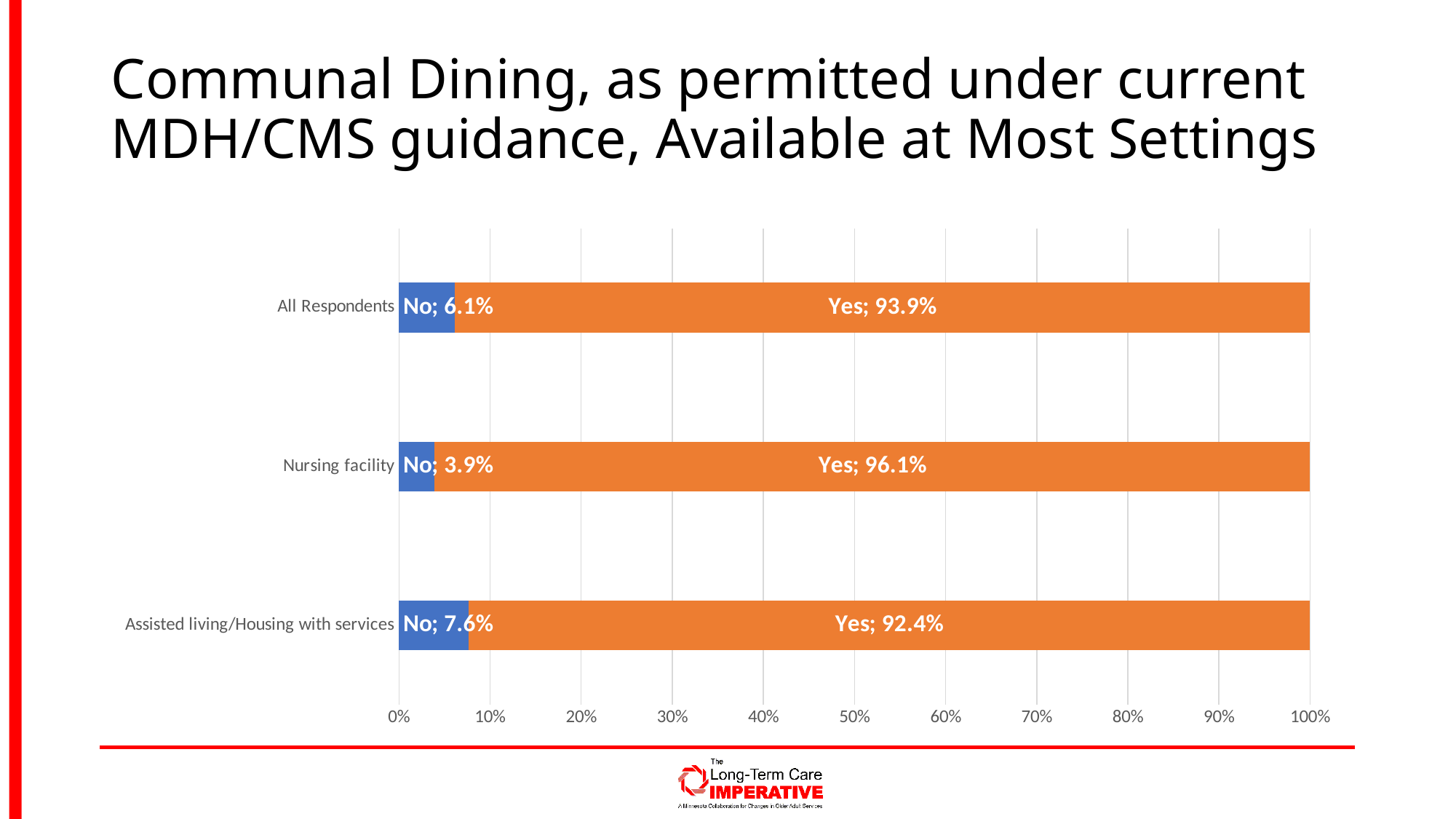
Which is larger: the No percentage for All Respondents or the No percentage for Assisted living/Housing with services? Assisted living/Housing with services Is the Yes value for Nursing facility greater or less than 90%? greater Which category has the lowest No percentage? Nursing facility What percentage of Assisted living/Housing with services respondents answered Yes? 92.4% What is the difference between the No percentage for Assisted living/Housing with services and the No percentage for Nursing facility? 3.7% What is the total of the No and Yes segments for All Respondents? 100% What percentage of All Respondents answered Yes? 93.9% How many categories are shown on the chart? 3 What kind of chart is shown on the slide? Stacked bar chart Which category has the highest Yes percentage? Nursing facility What colour are the Yes segments of the bars? Orange What percentage of Nursing facility respondents answered No? 3.9%